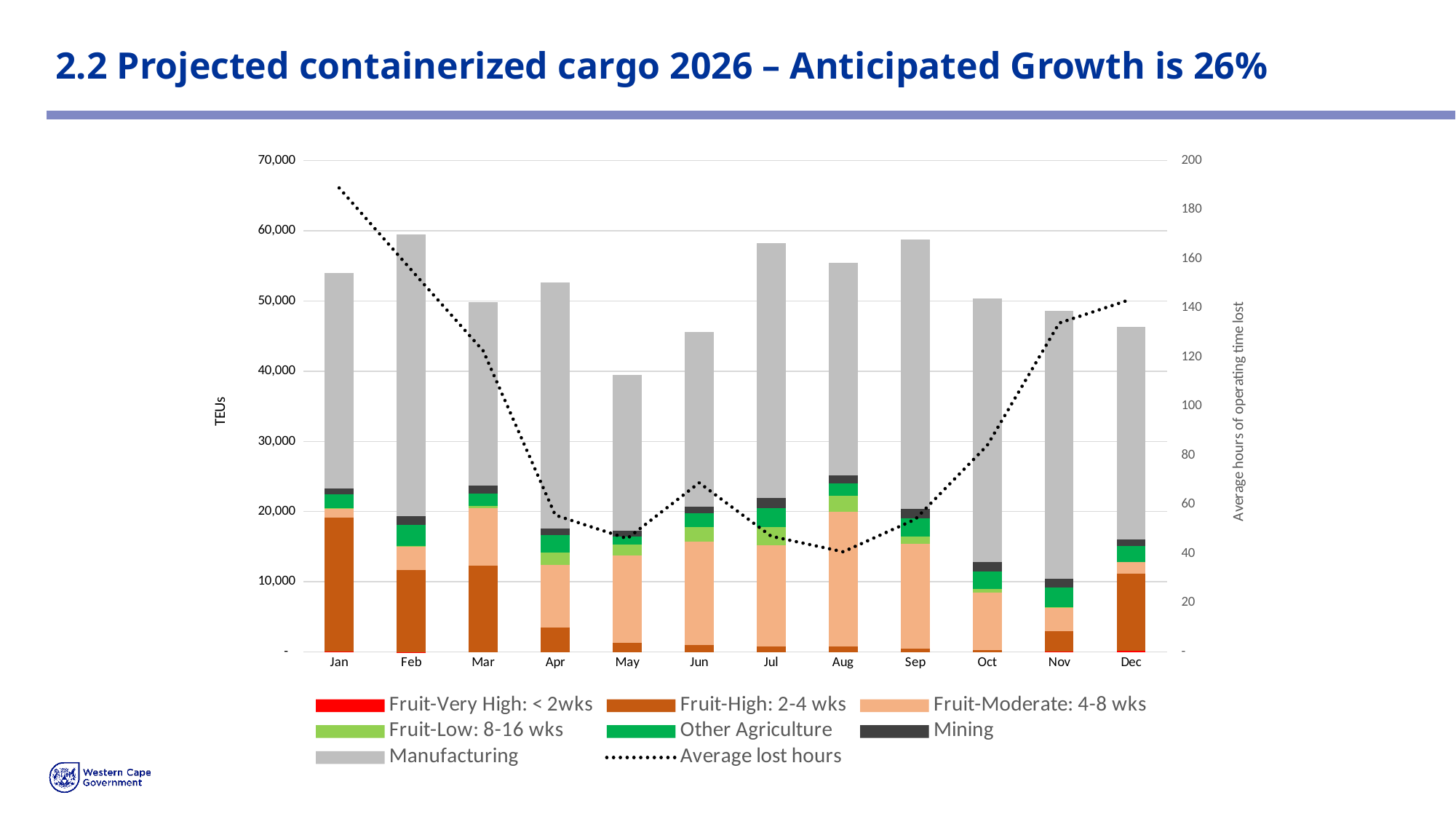
In which month is the Average lost hours line at its highest? Jan What is the label on the right-hand vertical axis of the chart? Average hours of operating time lost How many series does the chart's legend list? 8 Is the Average lost hours value for Jan greater or less than 160? greater Which month has the larger total TEUs bar, Jul or Jun? Jul What kind of chart is shown on the slide? Stacked bar chart with a line Is the total TEUs bar for Jan greater or less than 50,000? greater Is the Average lost hours value for Aug greater or less than 60? less How many months are shown on the x axis of the chart? 12 Which month has the lowest total stacked bar (TEUs)? May Does the Average lost hours line rise or fall from Aug to Dec? rise